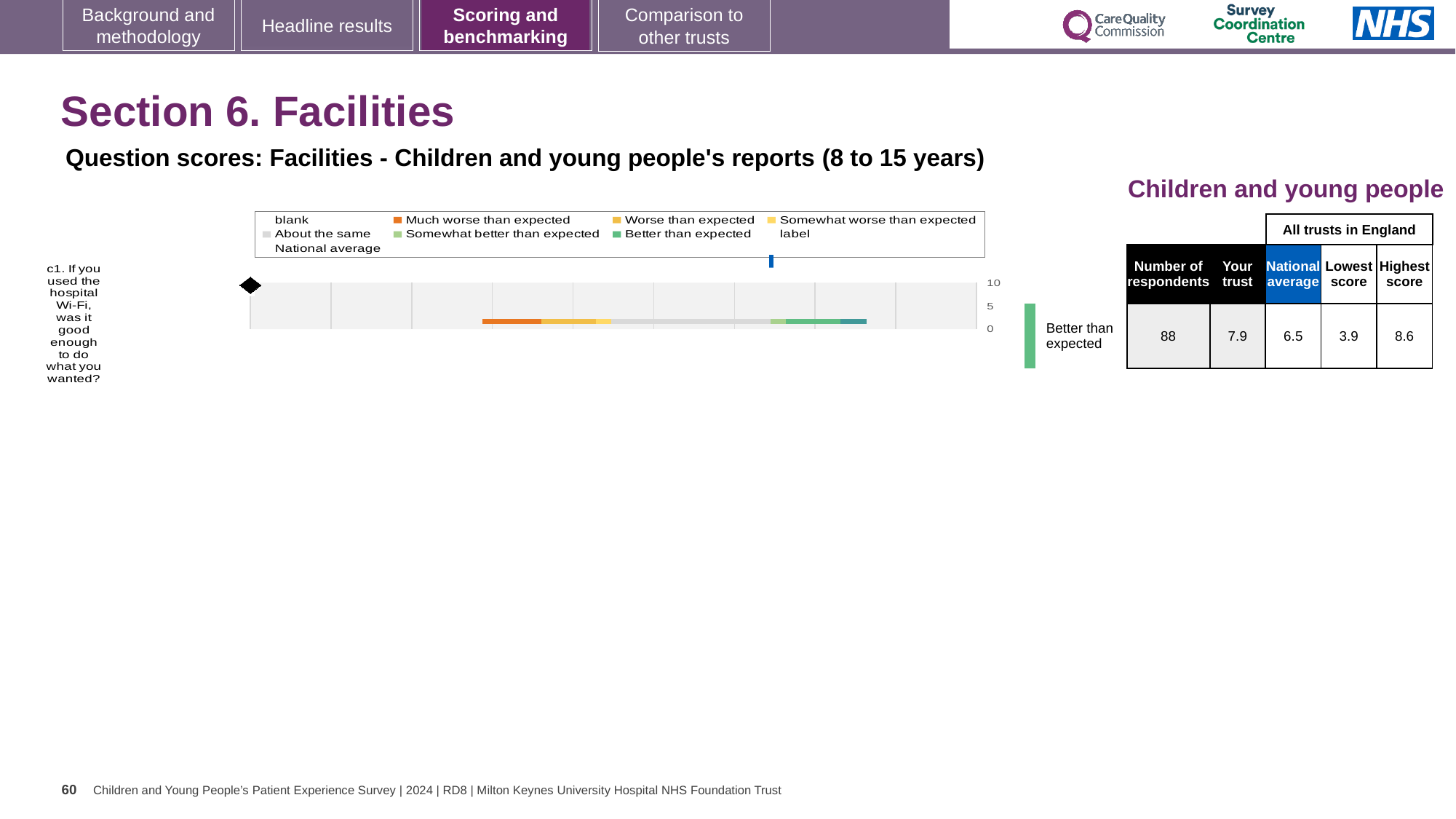
What is the 'Your trust' score for question c1 about the hospital Wi-Fi? 7.9 What is the highest score among all trusts in England for question c1? 8.6 For question c1, which is higher: the 'Your trust' score or the national average? Your trust For question c1, what is the difference between the highest score and the lowest score among all trusts in England? 4.7 What is the maximum value shown on the chart's numeric axis? 10 How many questions (categories) are plotted on the chart? 1 What is the lowest score among all trusts in England for question c1? 3.9 How many respondents answered question c1 about the hospital Wi-Fi? 88 What kind of chart is shown on the slide? bar chart How is the trust's result for question c1 categorised relative to expectations? Better than expected For question c1, what is the difference between the 'Your trust' score and the national average? 1.4 What is the national average score for question c1 about the hospital Wi-Fi? 6.5